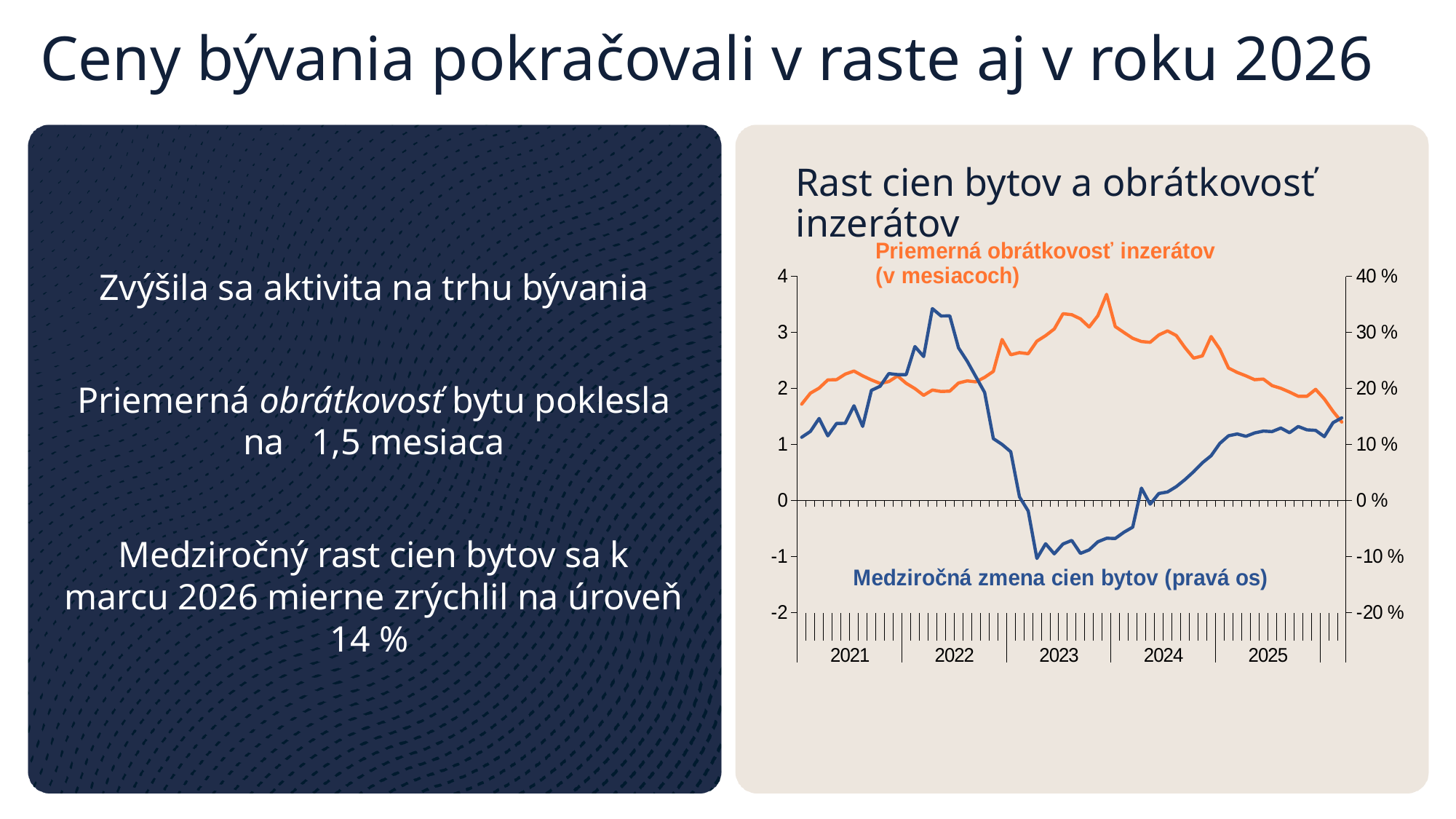
What is the title of the chart on the slide? Rast cien bytov a obrátkovosť inzerátov Does the 'Medziročná zmena cien bytov' series rise or fall between its 2022 peak and 2023? fall How many data series are plotted in the chart 'Rast cien bytov a obrátkovosť inzerátov'? 2 Does the 'Medziročná zmena cien bytov' series rise or fall from 2023 to 2025? rise Is the value of 'Medziročná zmena cien bytov' at the end of the series greater or less than 10 %? greater What kind of chart is shown on the slide? line chart Is the peak value of the 'Medziročná zmena cien bytov' series in 2022 greater or less than 30 %? greater How many year labels are shown on the x axis of the chart? 5 Does the 'Priemerná obrátkovosť inzerátov' series rise or fall from its 2023 peak to the end of 2025? fall Is the peak value of the 'Priemerná obrátkovosť inzerátov' series in 2023 greater or less than 3? greater Which series is plotted against the right axis? Medziročná zmena cien bytov